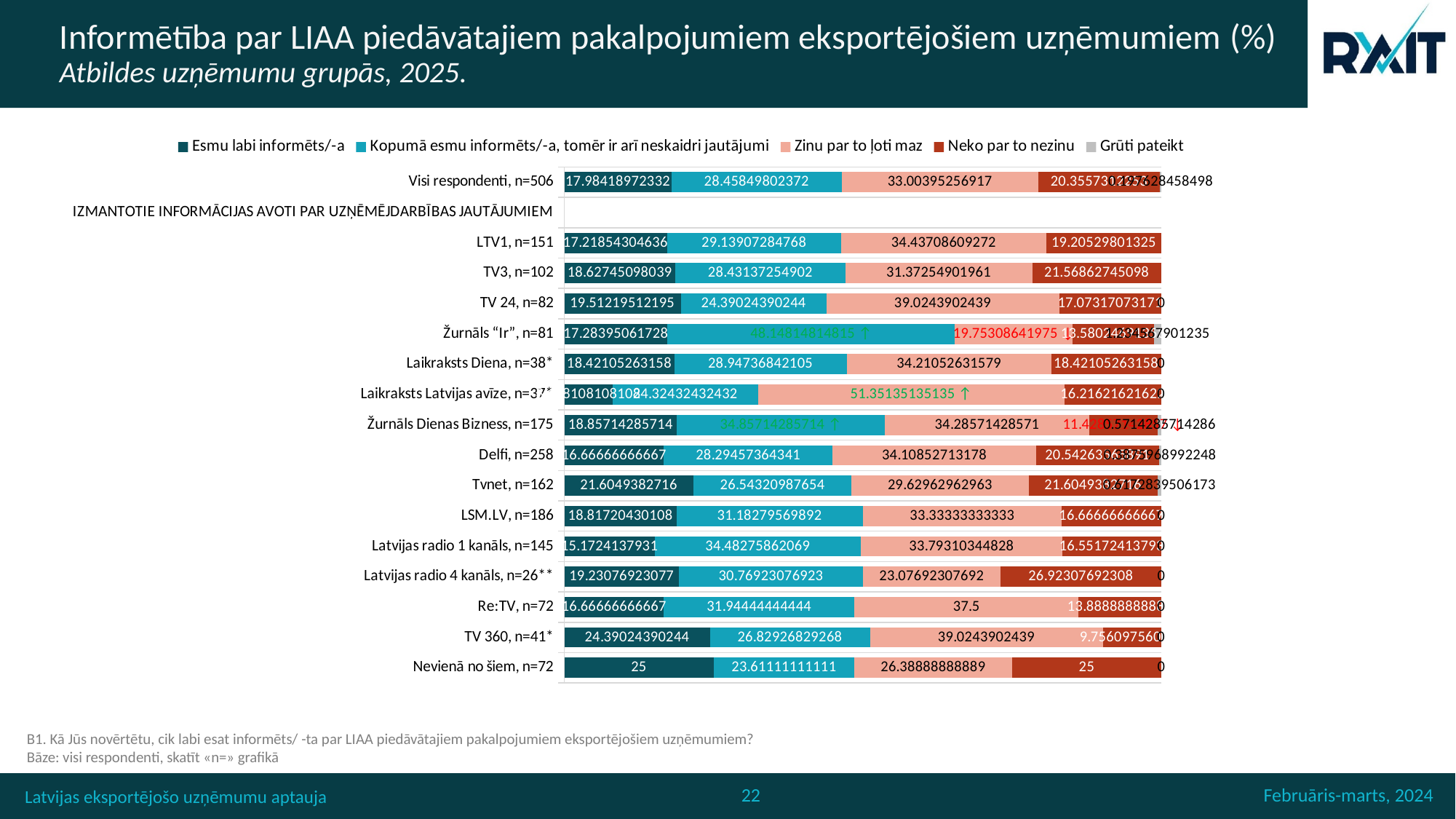
What is the legend label of the darkest teal series (first in the legend)? Esmu labi informēts/-a What is the value of "Neko par to nezinu" for "Latvijas radio 4 kanāls, n=26**"? 26.92307692308 What is the value of "Esmu labi informēts/-a" for "Nevienā no šiem, n=72"? 25 Which group has the highest value for "Zinu par to ļoti maz"? Laikraksts Latvijas avīze, n=37* How many series does the legend list? 5 What is the value of "Zinu par to ļoti maz" for "Re:TV, n=72"? 37.5 What is the difference between "Zinu par to ļoti maz" and "Esmu labi informēts/-a" for "Nevienā no šiem, n=72"? 1.38888888889 What is the value of "Kopumā esmu informēts/-a, tomēr ir arī neskaidri jautājumi" for "LSM.LV, n=186"? 31.18279569892 What is the value of "Zinu par to ļoti maz" for "Laikraksts Latvijas avīze, n=37*"? 51.35135135135 Which is larger for "Zinu par to ļoti maz": "TV 24, n=82" or "Re:TV, n=72"? TV 24, n=82 Which group has the highest value for "Kopumā esmu informēts/-a, tomēr ir arī neskaidri jautājumi"? Žurnāls "Ir", n=81 What kind of chart is shown on the slide? stacked bar chart